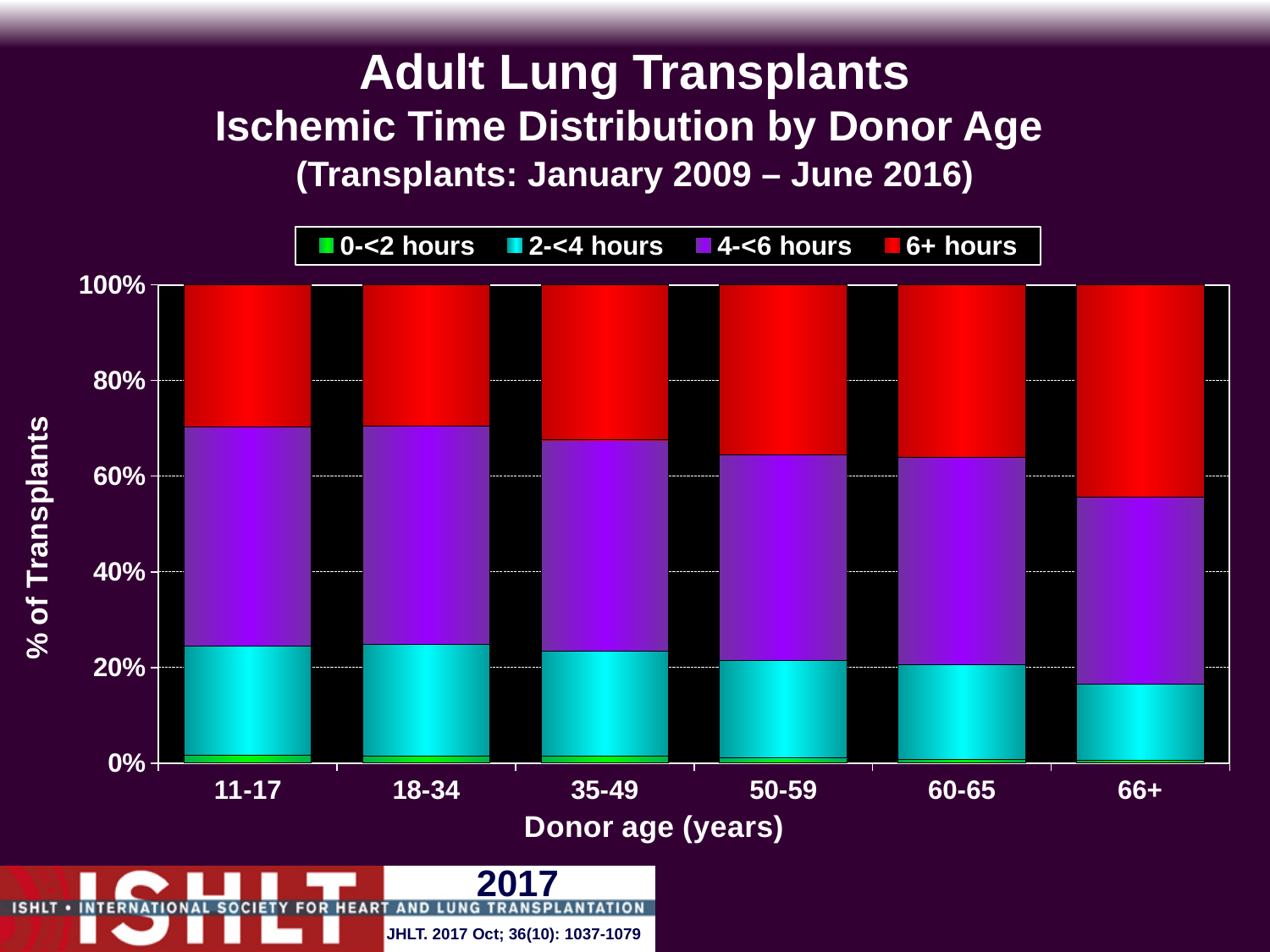
Which donor age group has the largest share of transplants with an ischemic time of 6+ hours? 66+ How many donor age categories are shown on the x axis? 6 Which is larger for the 66+ donor age group: the 6+ hours share or the 2-<4 hours share? 6+ hours How many series does the legend list? 4 Which donor age group has the smallest share of transplants with an ischemic time of 2-<4 hours? 66+ What kind of chart is shown on the slide? Stacked bar chart What is the label of the x axis? Donor age (years) Is the share of 6+ hours ischemic time for the 11-17 donor age group greater or less than 40%? less Is the share of 2-<4 hours ischemic time for the 66+ donor age group greater or less than 20%? less Is the share of 6+ hours ischemic time for the 66+ donor age group greater or less than 40%? greater Which donor age group has the smallest share of transplants with an ischemic time of 4-<6 hours? 66+ Does the share of transplants with 6+ hours ischemic time rise or fall as donor age increases along the x axis? rise